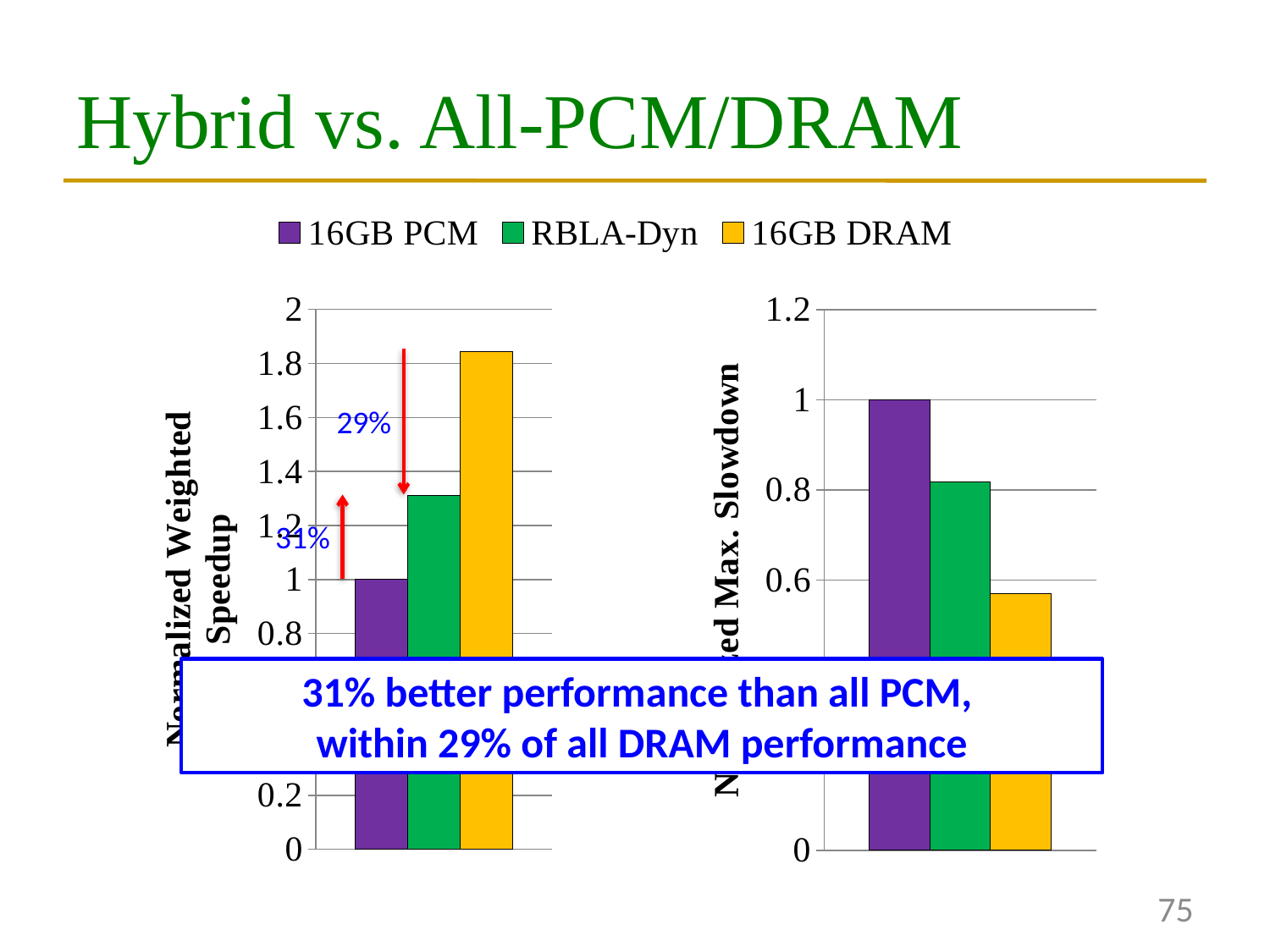
How many series does the legend list? 3 In the left chart (Normalized Weighted Speedup), is the value for 16GB DRAM greater or less than 1.8? greater In the right chart (Normalized Max. Slowdown), which is larger, the value for RBLA-Dyn or the value for 16GB DRAM? RBLA-Dyn In the right chart (Normalized Max. Slowdown), which series has the highest bar? 16GB PCM In the left chart (Normalized Weighted Speedup), what is the value for 16GB PCM? 1 In the right chart (Normalized Max. Slowdown), which series has the lowest bar? 16GB DRAM What kind of chart is the left chart (Normalized Weighted Speedup)? bar chart In the left chart (Normalized Weighted Speedup), which series has the lowest bar? 16GB PCM What colour are the RBLA-Dyn bars? green In the left chart (Normalized Weighted Speedup), which series has the highest bar? 16GB DRAM In the left chart (Normalized Weighted Speedup), is the value for RBLA-Dyn greater or less than 1.2? greater